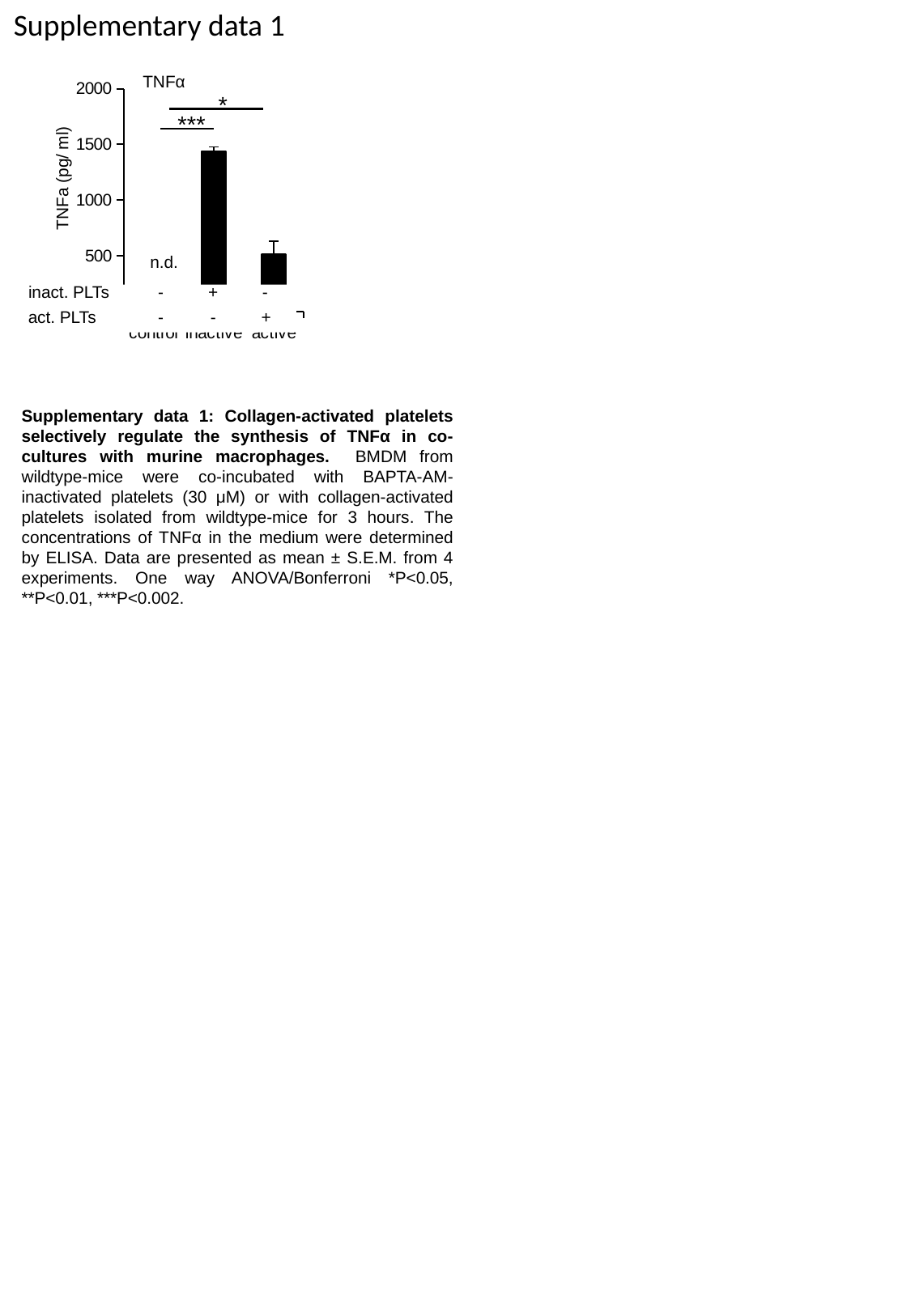
Is the TNFα value for the inactive platelets condition greater or less than 1000? greater Is the TNFα value for the active platelets condition greater or less than 1000? less What is the highest tick value shown on the y axis of the chart? 2000 Which condition has the highest TNFα value in the chart? inactive (inact. PLTs +) Which condition is marked as n.d. (not detected) in the TNFα chart? control What kind of chart is shown on the slide? bar chart Which has a larger TNFα value: the inactive platelets condition or the active platelets condition? inactive platelets How many categories (bars/conditions) are shown on the x axis of the TNFα chart? 3 What is the label of the y axis of the chart? TNFa (pg/ ml) Is the TNFα value for the inactive platelets condition greater or less than 500? greater